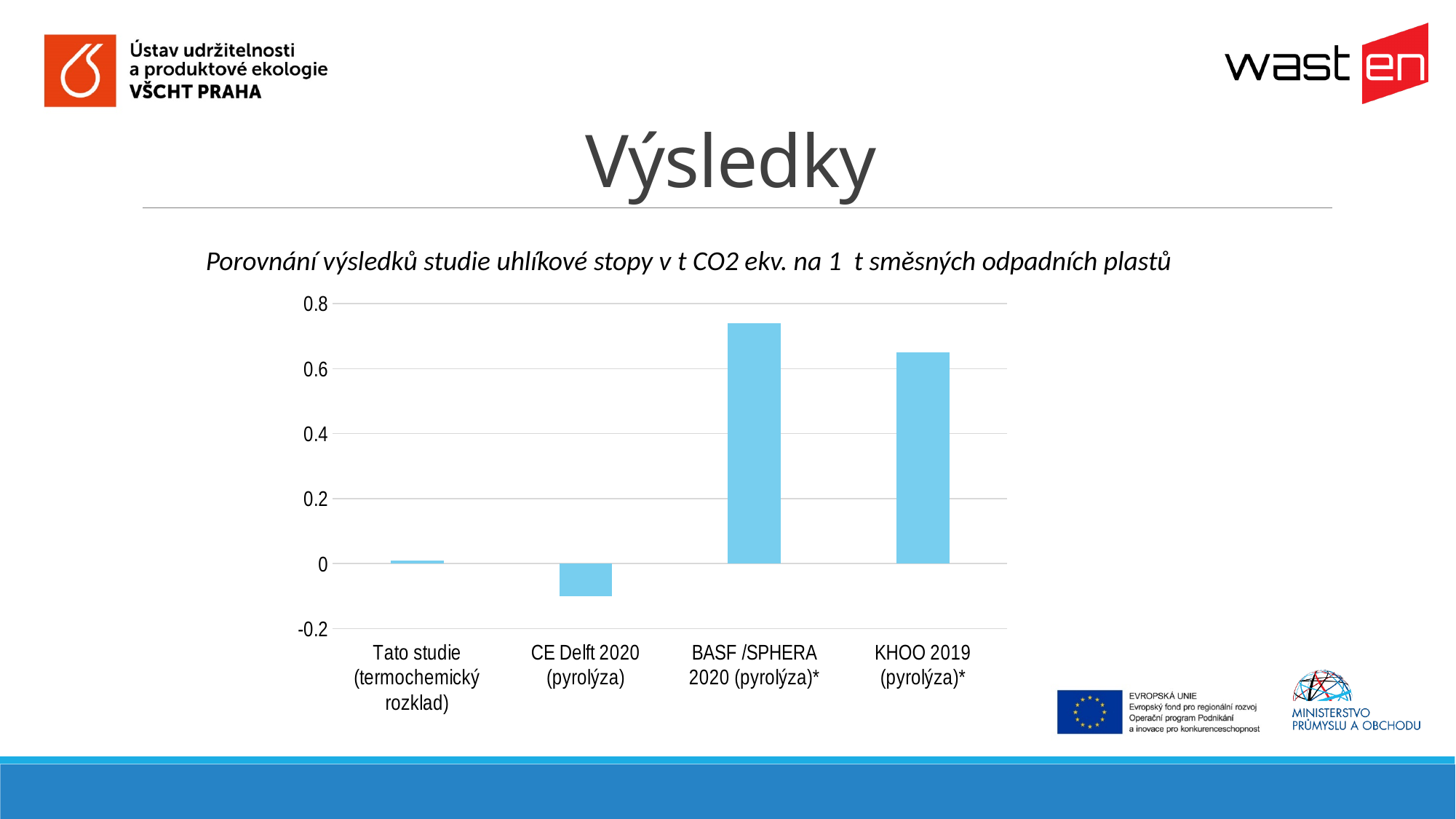
How many categories (studies) are shown on the x axis of the chart? 4 Which has the larger value: BASF /SPHERA 2020 (pyrolýza)* or KHOO 2019 (pyrolýza)*? BASF /SPHERA 2020 (pyrolýza)* Which study has the highest value in the chart? BASF /SPHERA 2020 (pyrolýza)* Which has the larger value: Tato studie (termochemický rozklad) or CE Delft 2020 (pyrolýza)? Tato studie (termochemický rozklad) Is the value for Tato studie (termochemický rozklad) greater or less than 0.2? less What kind of chart is shown on the slide? bar chart Is the value for CE Delft 2020 (pyrolýza) greater or less than 0? less What is the title of the chart on the slide? Porovnání výsledků studie uhlíkové stopy v t CO2 ekv. na 1 t směsných odpadních plastů Which study is the only one with a negative value in the chart? CE Delft 2020 (pyrolýza) Is the value for KHOO 2019 (pyrolýza)* greater or less than 0.8? less Which study has the lowest value in the chart? CE Delft 2020 (pyrolýza)